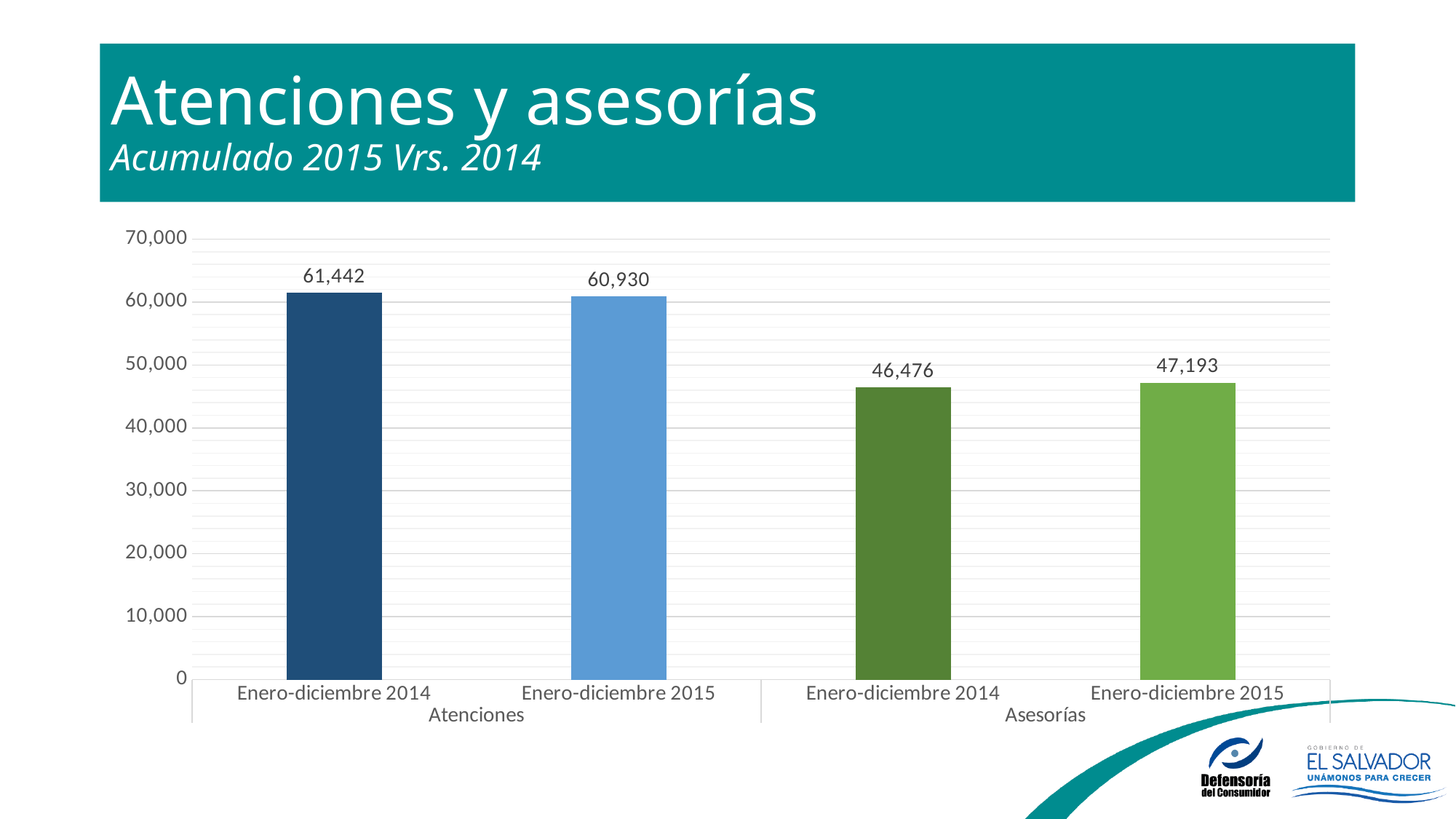
What is the value for Atenciones in Enero-diciembre 2014? 61,442 What is the value for Asesorías in Enero-diciembre 2014? 46,476 What is the difference between Asesorías in 2015 and Asesorías in 2014? 717 How many bars are plotted on the chart? 4 What kind of chart is shown on the slide? Bar chart What is the difference between Atenciones in 2014 and Atenciones in 2015? 512 What is the value for Asesorías in Enero-diciembre 2015? 47,193 What is the value for Atenciones in Enero-diciembre 2015? 60,930 Which bar has the lowest value? Asesorías, Enero-diciembre 2014 Which bar has the highest value? Atenciones, Enero-diciembre 2014 Which is larger: Asesorías in Enero-diciembre 2014 or Asesorías in Enero-diciembre 2015? Asesorías in Enero-diciembre 2015 Is the value for Asesorías in Enero-diciembre 2015 greater or less than 50,000? less